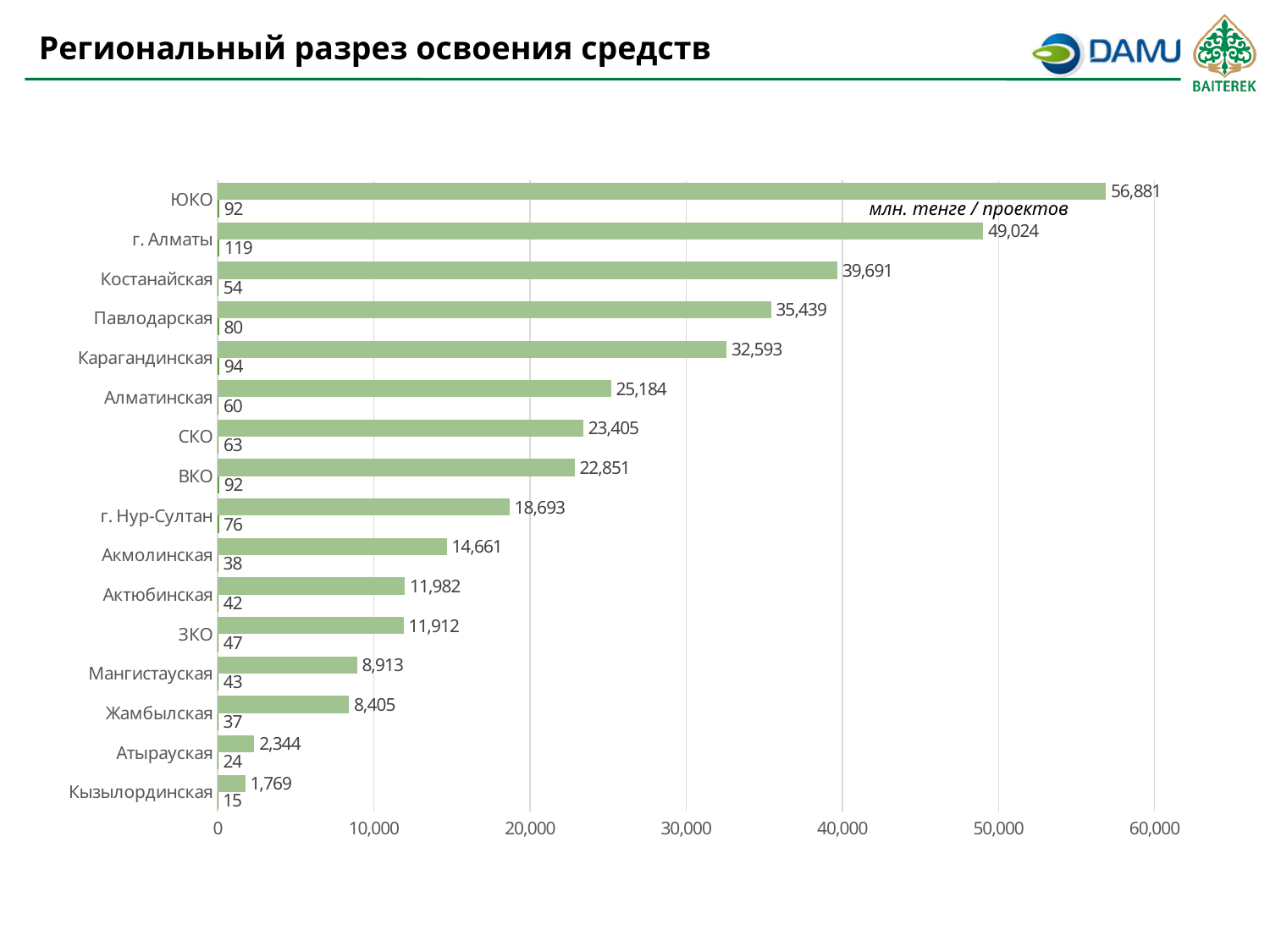
Which has a larger amount in млн. тенге, Павлодарская or Карагандинская? Павлодарская Which region has the lowest amount in млн. тенге? Кызылординская How many projects (проектов) are shown for г. Алматы? 119 Is the amount in млн. тенге for Алматинская greater or less than 20,000? greater What is the amount in млн. тенге for Мангистауская? 8,913 How many regions are shown on the chart? 16 Which region has the highest number of projects (проектов)? г. Алматы What is the amount in млн. тенге for Костанайская? 39,691 What is the difference in млн. тенге between ЮКО and г. Алматы? 7,857 Which region has the highest amount in млн. тенге? ЮКО What kind of chart is shown on the slide? bar chart What is the title of the slide? Региональный разрез освоения средств